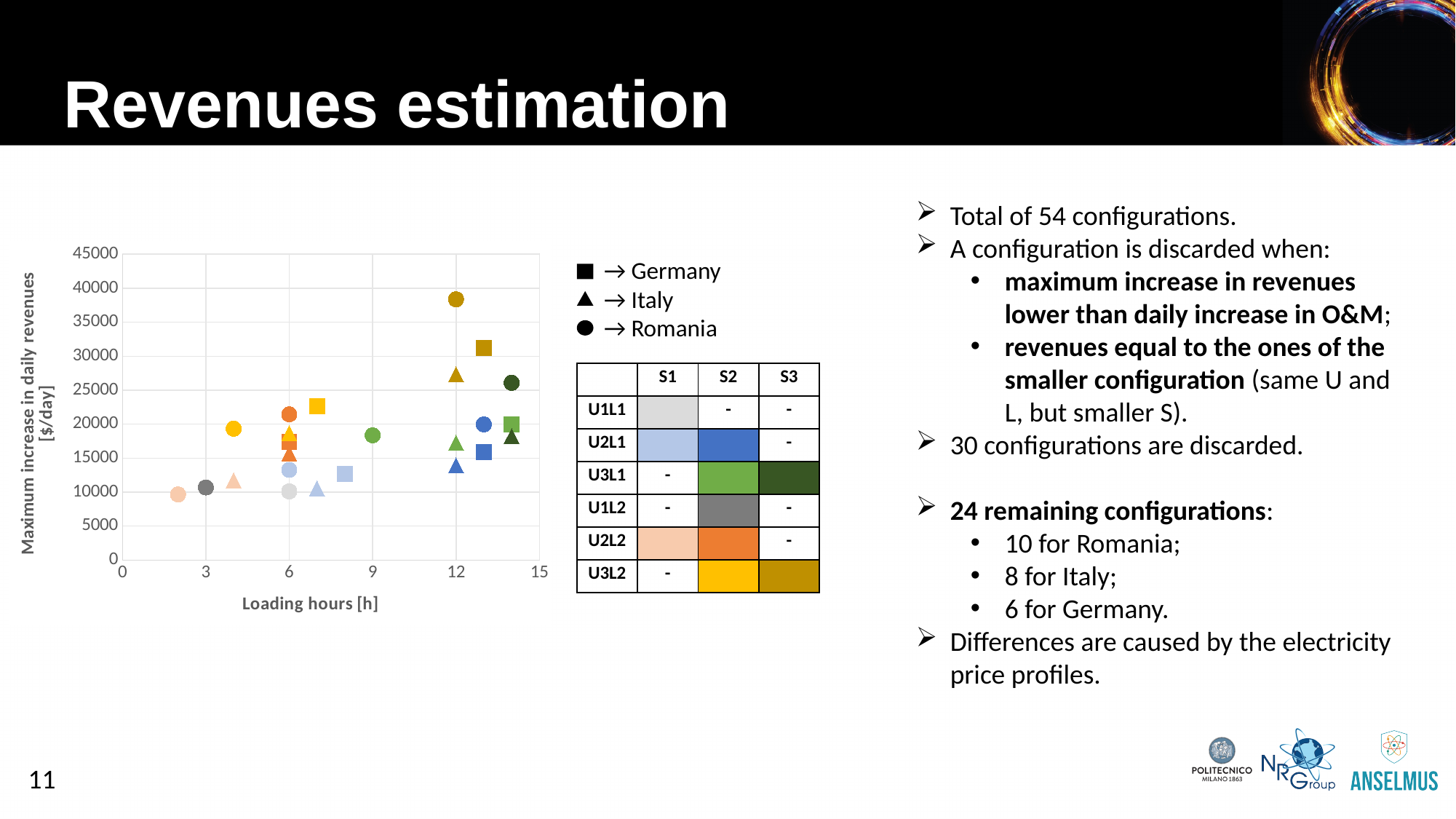
Which country has the point with the highest maximum increase in daily revenues? Romania Is the Romania (circle) point at 12 loading hours greater or less than 35000 $/day? greater Is the highest Germany (square) point at 13 loading hours greater or less than 30000 $/day? greater What kind of chart is shown on the slide? scatter chart Is the highest plotted point in the chart greater or less than 35000 $/day? greater What is the maximum value shown on the x axis of the chart? 15 Which marker shape represents Romania in the chart? circle How many countries does the chart legend list? 3 What is the label of the x axis of the chart? Loading hours [h]